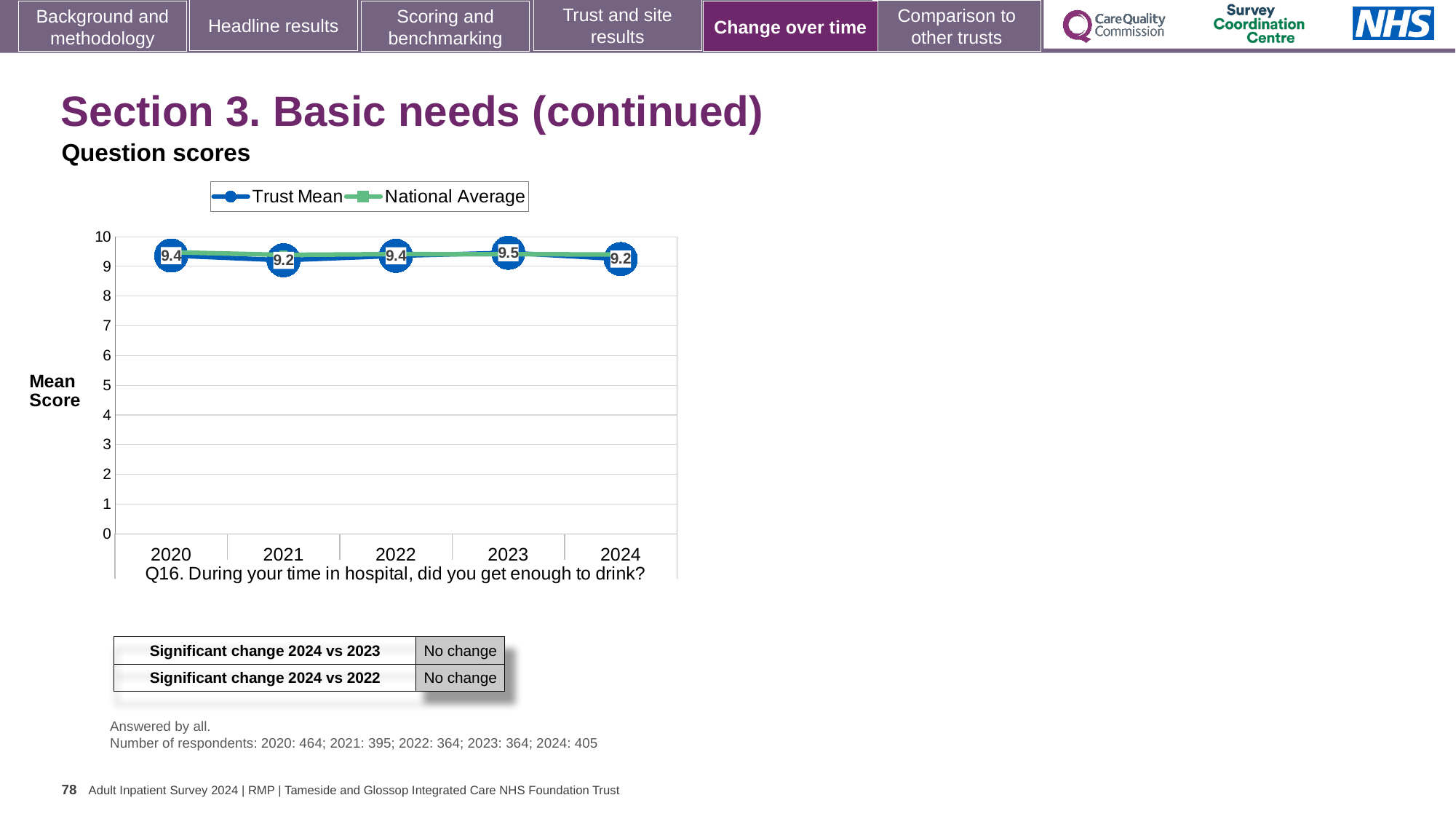
How many series does the legend list? 2 Does the Trust Mean rise or fall from 2023 to 2024? fall What kind of chart is shown? line chart Which year has the larger Trust Mean, 2021 or 2023? 2023 Is the National Average value for 2020 greater or less than 9? greater What is the Trust Mean value for 2021? 9.2 How many years are plotted on the x axis? 5 What is the difference between the Trust Mean in 2023 and in 2024? 0.3 Which survey question does the chart show scores for? Q16. During your time in hospital, did you get enough to drink? In which year is the Trust Mean highest? 2023 What is the Trust Mean value for 2023? 9.5 What is the Trust Mean value for 2020? 9.4